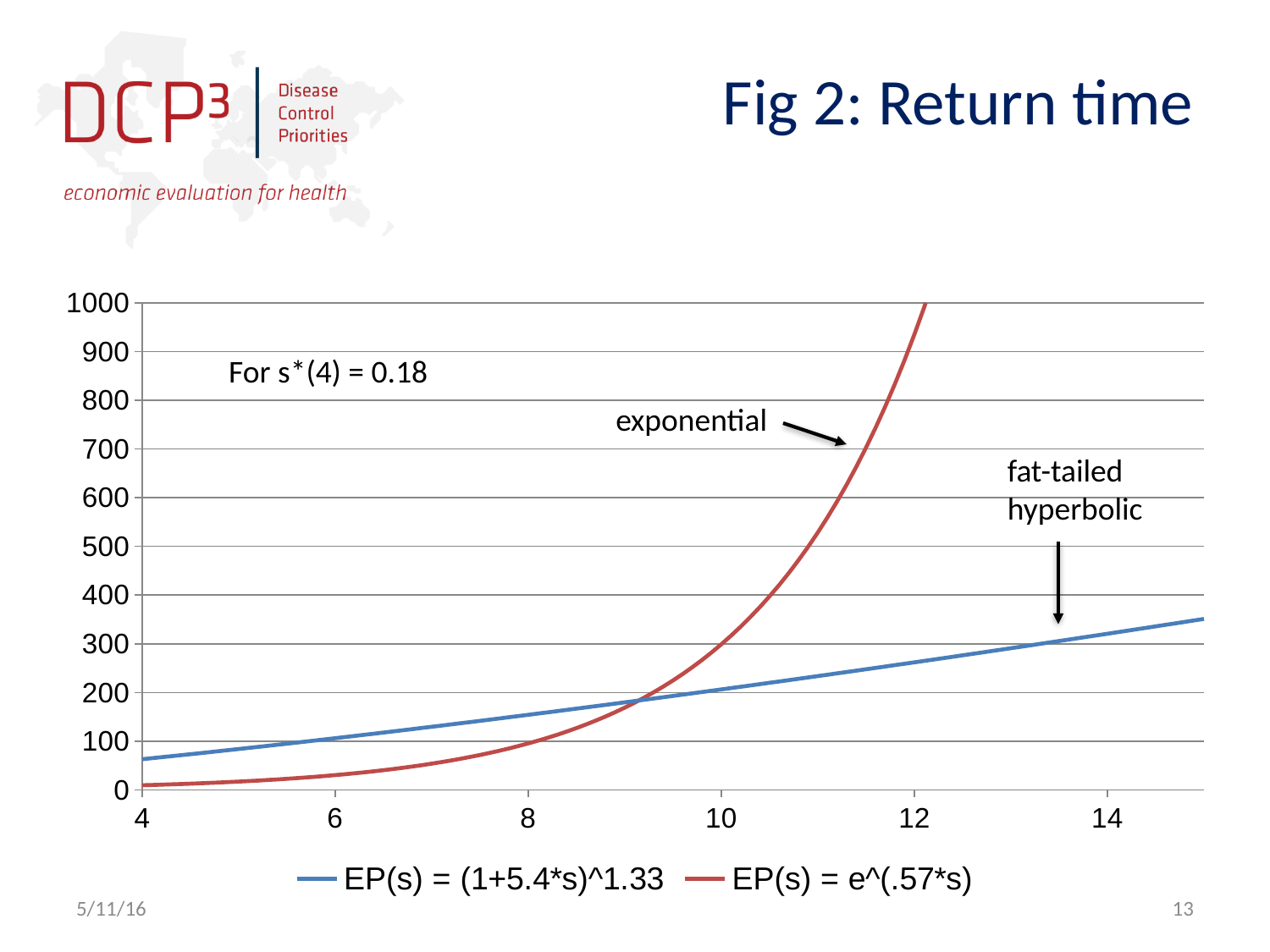
Do the values of the series EP(s) = (1+5.4*s)^1.33 rise or fall as s increases along the x axis? rise Is the value of EP(s) = (1+5.4*s)^1.33 at s = 14 greater or less than 200? greater How many series does the legend list? 2 Is the value of EP(s) = e^(.57*s) at s = 12 greater or less than 500? greater Do the values of the series EP(s) = e^(.57*s) rise or fall as s increases along the x axis? rise Is the value of EP(s) = e^(.57*s) at s = 10 greater or less than 500? less What is the title of the chart on the slide? Fig 2: Return time What kind of chart is shown on the slide? line chart Which series is labelled with the annotation "exponential"? EP(s) = e^(.57*s) At s = 14, which series has the larger value, EP(s) = (1+5.4*s)^1.33 or EP(s) = e^(.57*s)? EP(s) = e^(.57*s) At s = 6, which series has the larger value, EP(s) = (1+5.4*s)^1.33 or EP(s) = e^(.57*s)? EP(s) = (1+5.4*s)^1.33